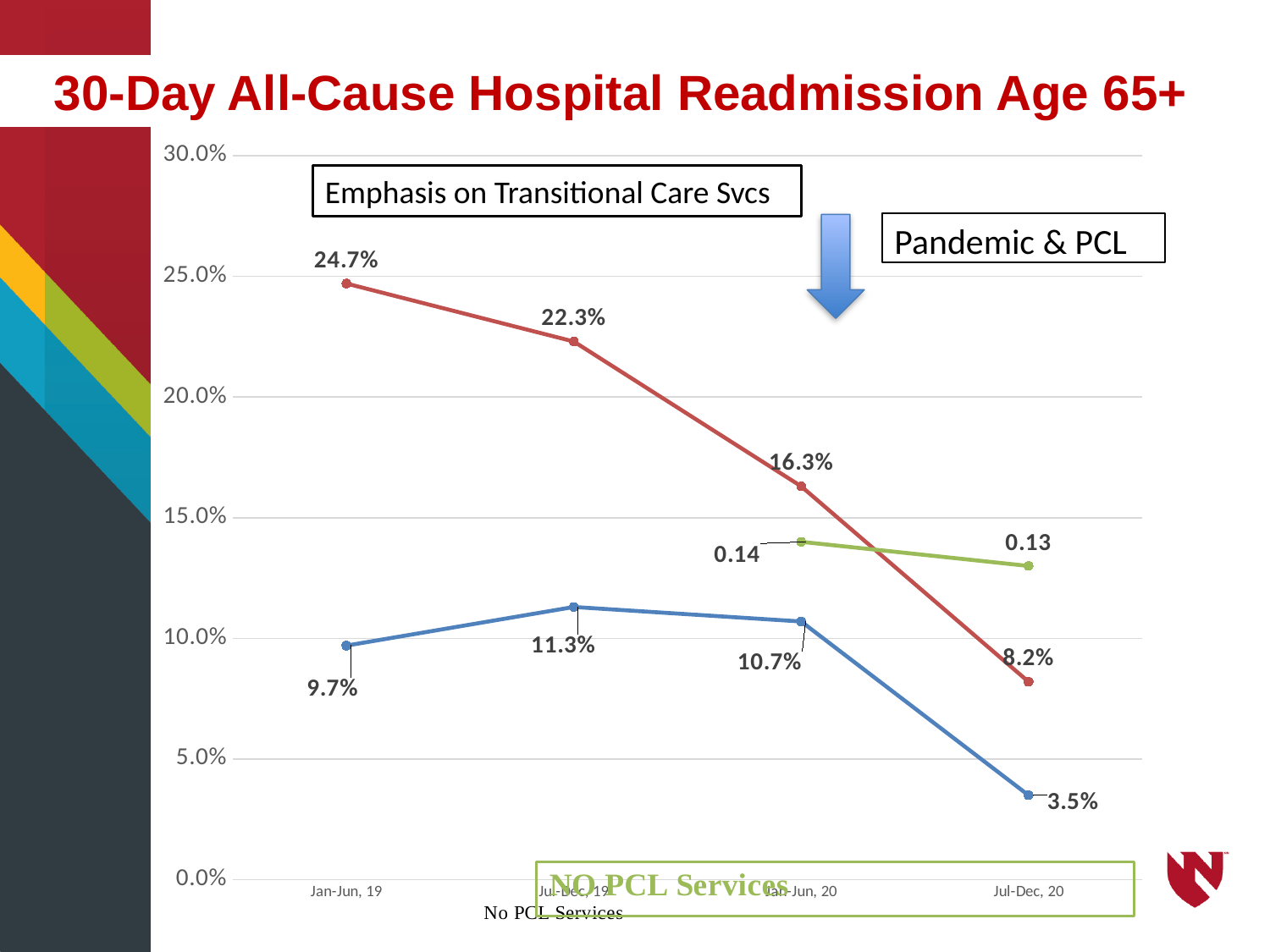
At which period does the red line reach its highest value? Jan-Jun, 19 What is the value of the red line at Jan-Jun, 19? 24.7% Which is larger at Jan-Jun, 20: the red line's value or the blue line's value? the red line's value What type of chart is shown on the slide? line chart What is the difference between the red line's values at Jan-Jun, 19 and Jul-Dec, 19? 2.4% How many periods are shown on the x axis? 4 At which period does the blue line reach its lowest value? Jul-Dec, 20 What is the value of the blue line at Jul-Dec, 19? 11.3% What is the title of the chart? 30-Day All-Cause Hospital Readmission Age 65+ What is the value of the green line at Jan-Jun, 20? 0.14 What is the value of the blue line at Jul-Dec, 20? 3.5% What is the value of the red line at Jul-Dec, 20? 8.2%